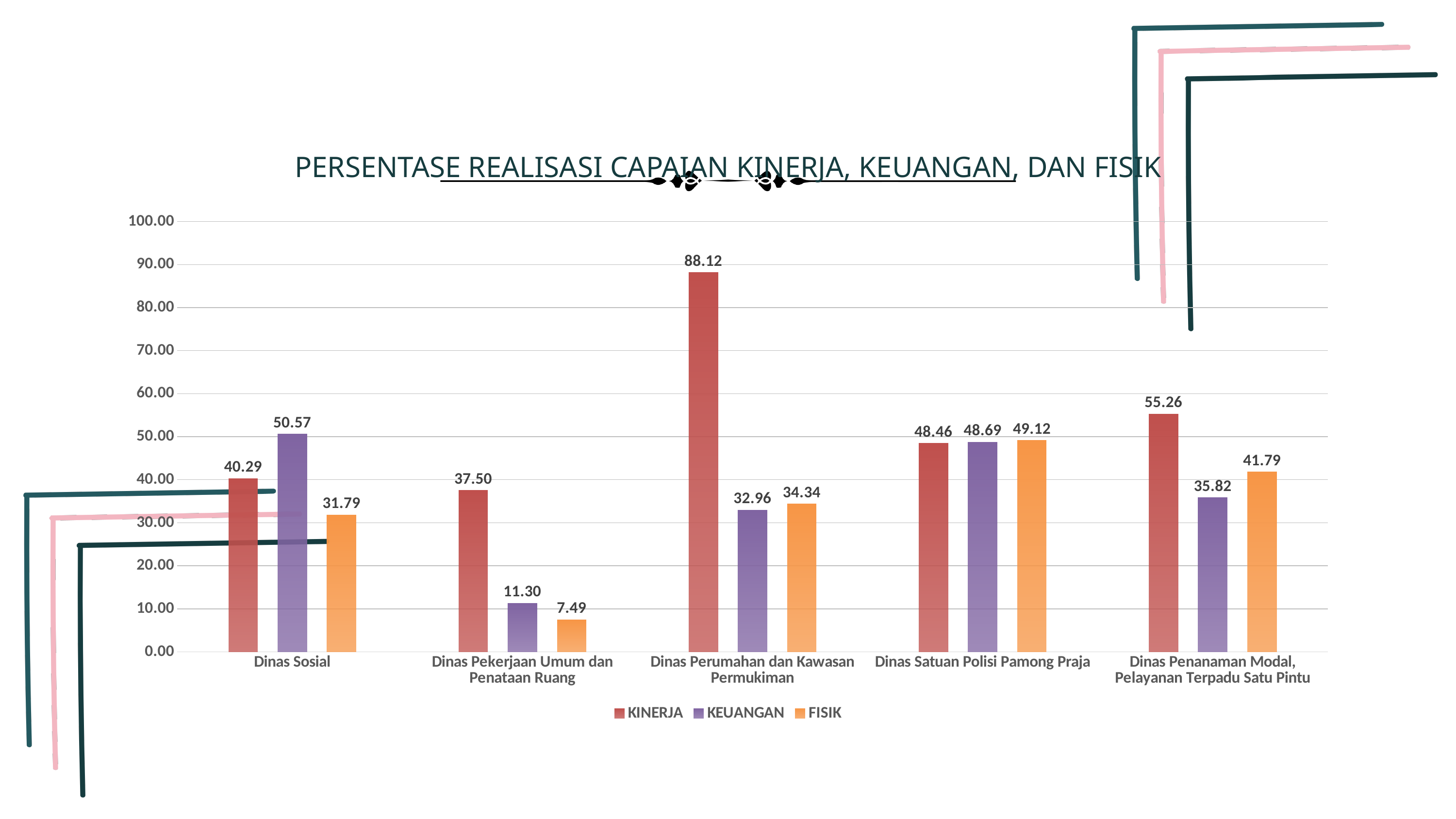
Is the KEUANGAN value for Dinas Perumahan dan Kawasan Permukiman greater or less than 40.00? less Which is larger for Dinas Penanaman Modal, Pelayanan Terpadu Satu Pintu: the KINERJA value or the FISIK value? KINERJA What is the FISIK value for Dinas Pekerjaan Umum dan Penataan Ruang? 7.49 What is the KINERJA value for Dinas Perumahan dan Kawasan Permukiman? 88.12 What is the KEUANGAN value for Dinas Penanaman Modal, Pelayanan Terpadu Satu Pintu? 35.82 What is the title of the chart? PERSENTASE REALISASI CAPAIAN KINERJA, KEUANGAN, DAN FISIK How many categories are shown on the x axis? 5 Which category has the highest KINERJA value? Dinas Perumahan dan Kawasan Permukiman What is the difference between the KINERJA and KEUANGAN values for Dinas Sosial? 10.28 Which category has the lowest KEUANGAN value? Dinas Pekerjaan Umum dan Penataan Ruang How many series does the legend list? 3 What kind of chart is shown on the slide? bar chart